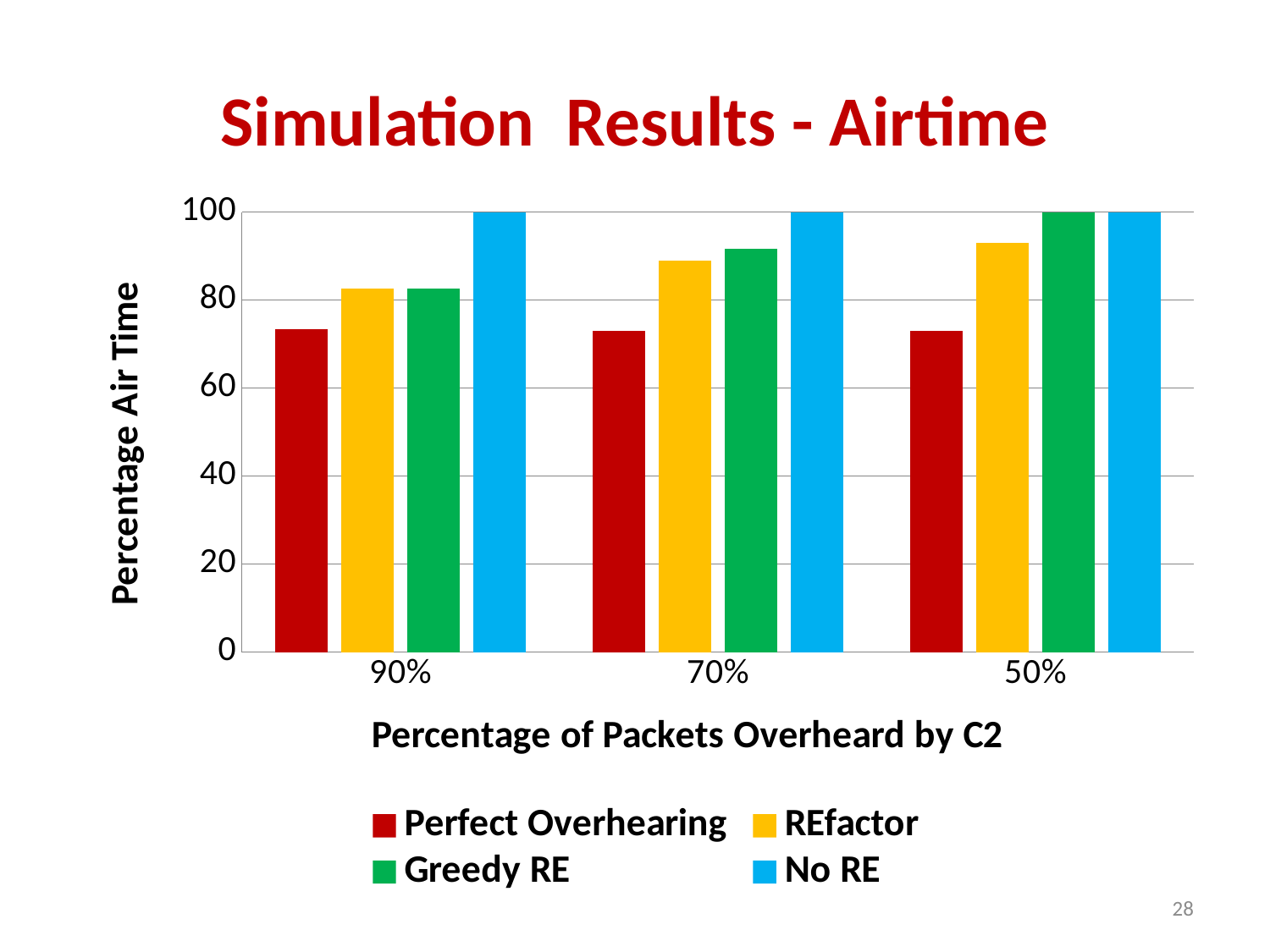
Is the value for REfactor at 70% greater or less than 80? greater At 50% packets overheard, which is larger: REfactor or Perfect Overhearing? REfactor How many series does the legend list? 4 How many categories are shown on the x axis? 3 Which series has the highest Percentage Air Time at 90% packets overheard? No RE What is the title of the chart's y axis? Percentage Air Time Which series has the lowest Percentage Air Time at 70% packets overheard? Perfect Overhearing Is the value for Perfect Overhearing at 90% greater or less than 80? less What kind of chart is shown on the slide? bar chart What is the Percentage Air Time for Greedy RE at 50% packets overheard? 100 What is the Percentage Air Time for No RE at 90% packets overheard? 100 What is the title of the chart's x axis? Percentage of Packets Overheard by C2